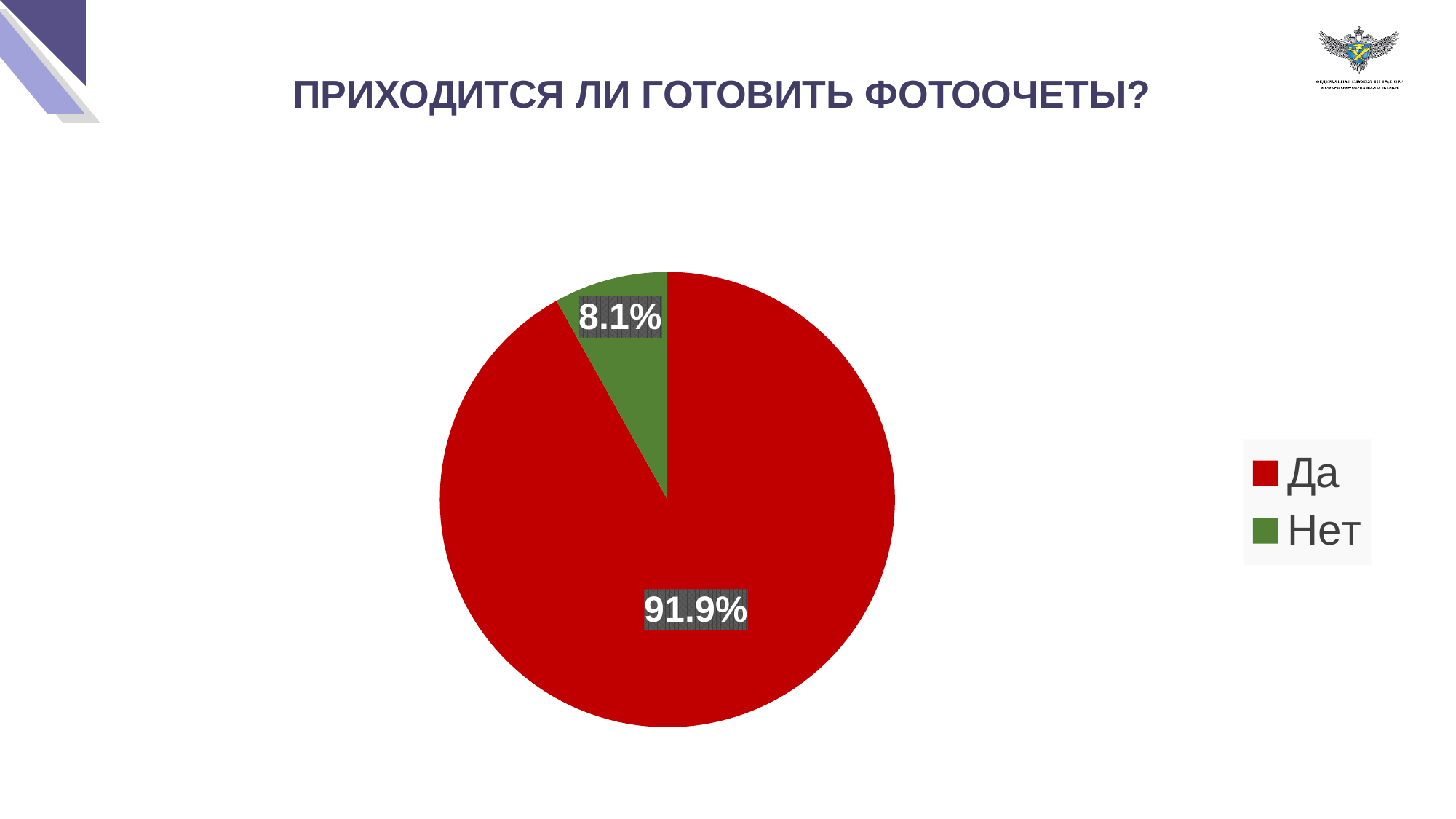
How many slices does the pie chart have? 2 How many entries does the legend list? 2 What is the difference in percentage points between the "Да" and "Нет" slices? 83.8 Which category has the largest slice of the pie? Да What share of the pie does "Нет" represent? 8.1% Which category has the smallest slice of the pie? Нет What kind of chart is shown on the slide? Pie chart Which slice is larger, "Да" or "Нет"? Да What share of the pie does "Да" represent? 91.9% What is the value shown for the "Да" slice? 91.9% What is the value shown for the "Нет" slice? 8.1% What colour is the "Нет" slice? Green